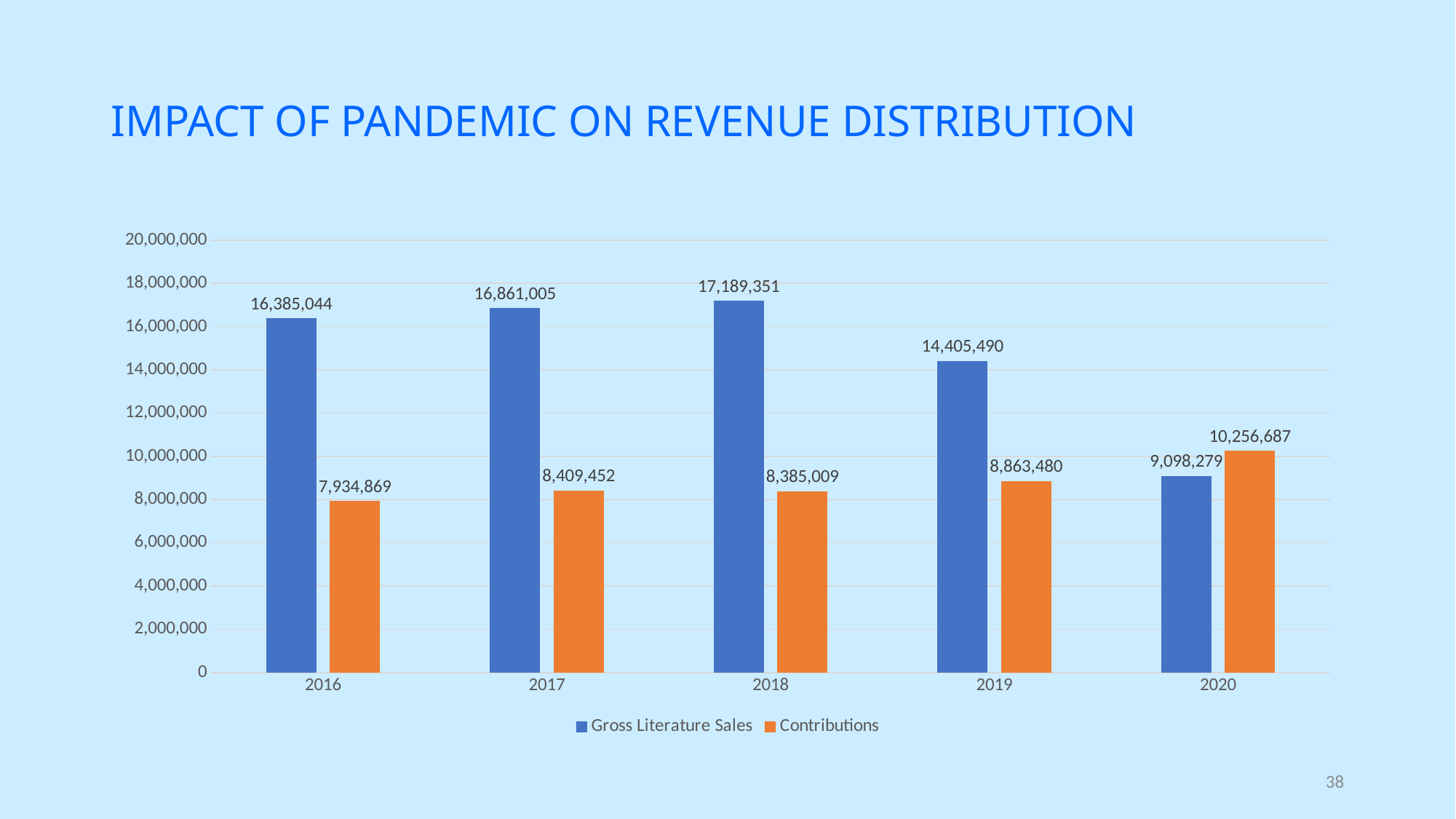
What is the value of Gross Literature Sales in 2018? 17,189,351 What kind of chart is shown on the slide? bar chart How many years are shown on the x axis? 5 What is the title of the slide? IMPACT OF PANDEMIC ON REVENUE DISTRIBUTION What is the difference between Gross Literature Sales and Contributions in 2019? 5,542,010 Is the value for Contributions in 2017 greater or less than 10,000,000? less What is the value of Gross Literature Sales in 2020? 9,098,279 Which is larger in 2020, Gross Literature Sales or Contributions? Contributions In which year were Contributions lowest? 2016 How many series does the legend list? 2 In which year were Gross Literature Sales highest? 2018 What is the value of Contributions in 2020? 10,256,687